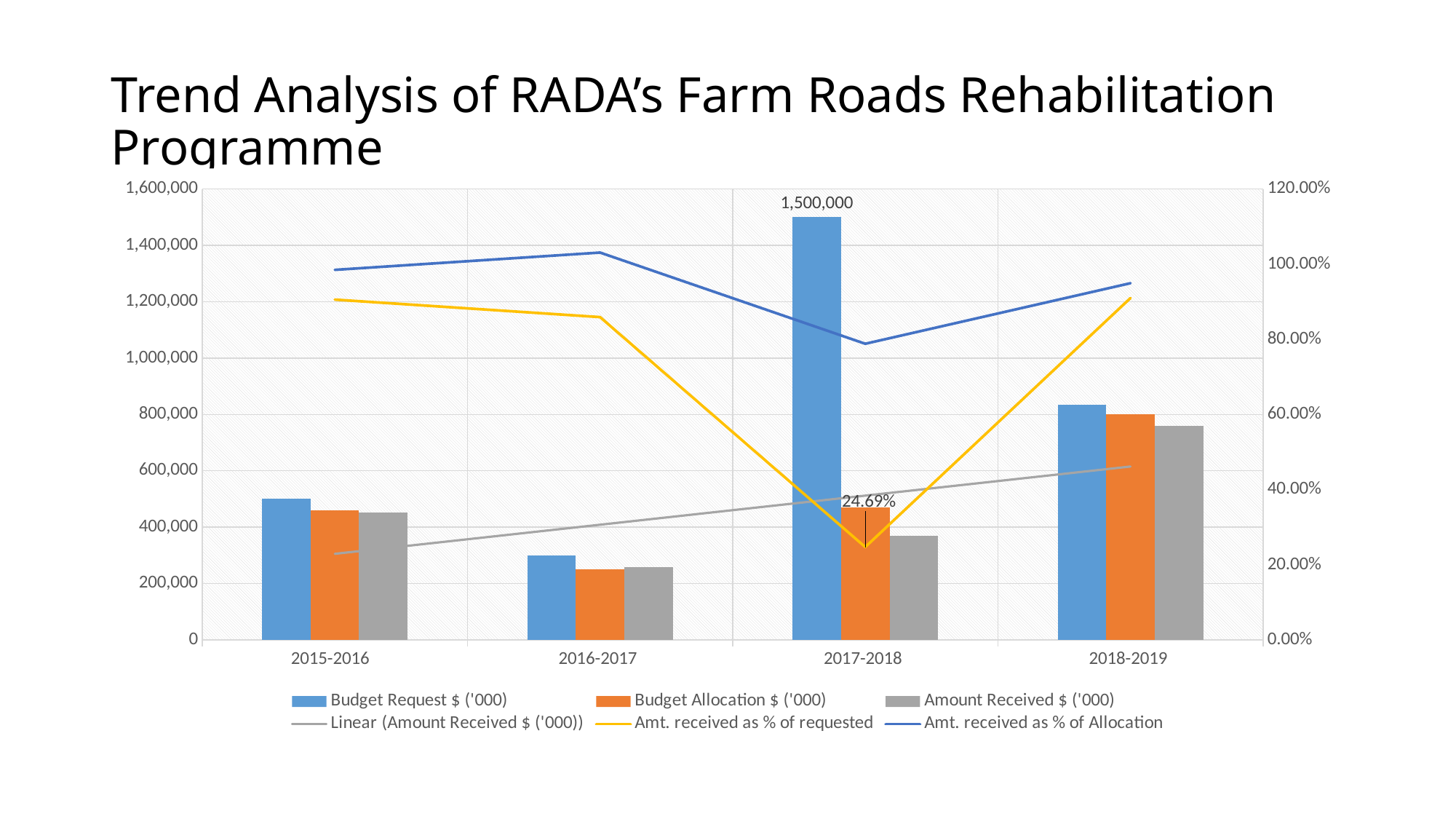
What is the Budget Request $ ('000) for 2017-2018? 1,500,000 Is the Budget Request $ ('000) for 2015-2016 greater or less than 600,000? less Which is larger, the Budget Allocation $ ('000) for 2018-2019 or for 2015-2016? 2018-2019 How many fiscal years are shown on the x axis? 4 Is the Amount Received $ ('000) for 2018-2019 greater or less than 600,000? greater How many series does the legend list? 6 Is the Amt. received as % of Allocation for 2015-2016 greater or less than 80.00%? greater In which fiscal year is the Amt. received as % of requested lowest? 2017-2018 What is the Amt. received as % of requested for 2017-2018? 24.69% Which fiscal year has the lowest Budget Request $ ('000)? 2016-2017 Does the Linear (Amount Received $ ('000)) trendline rise or fall from 2015-2016 to 2018-2019? rise Which fiscal year has the highest Budget Request $ ('000)? 2017-2018